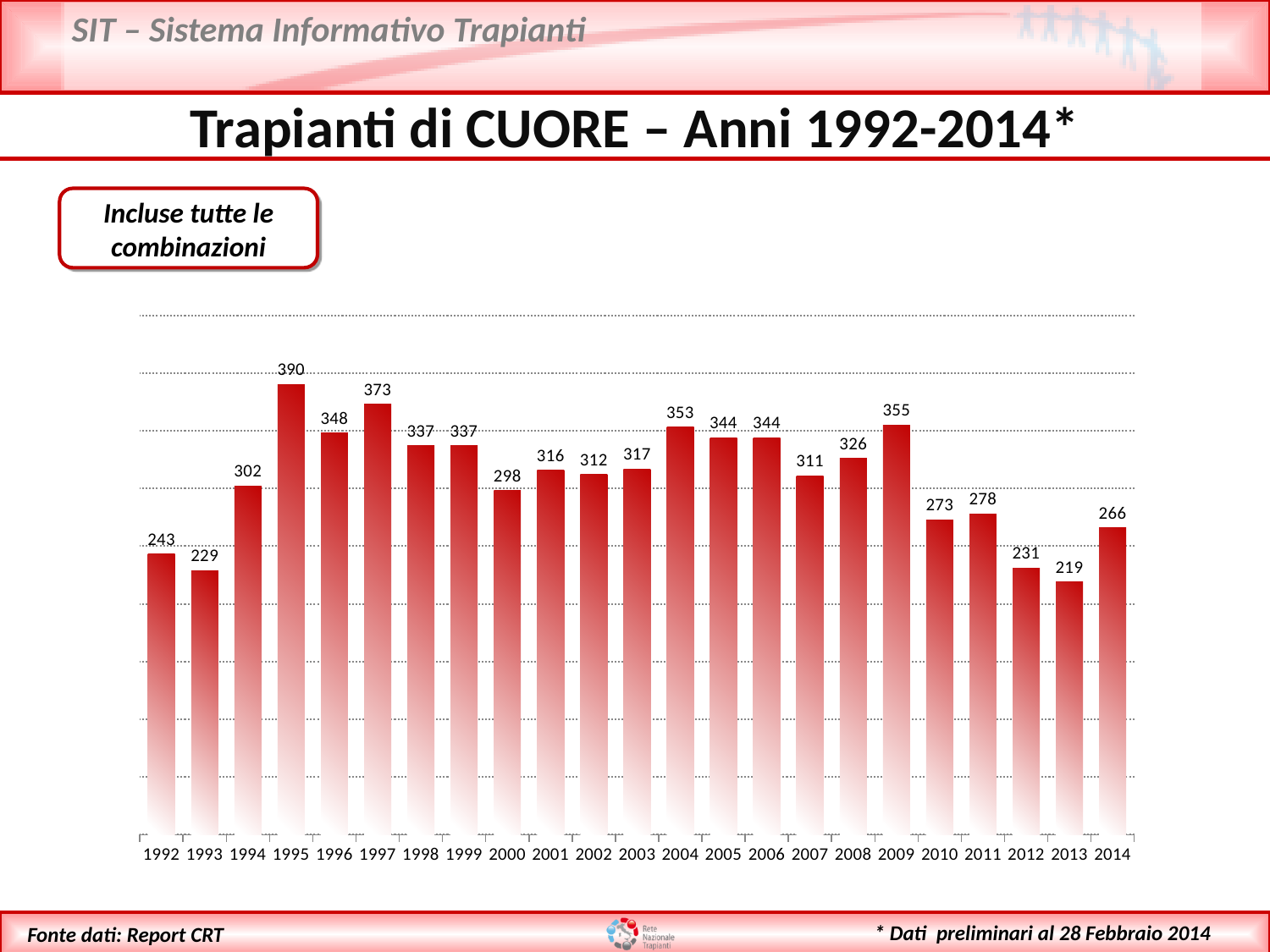
Which is larger, the value for 1992 or the value for 2012? 1992 What kind of chart is shown on the slide? bar chart What is the value for 2013? 219 What is the difference between the values for 1995 and 2013? 171 What is the value for 2009? 355 What is the value for 1995? 390 Which year has the highest value? 1995 What is the title of the slide's chart? Trapianti di CUORE – Anni 1992-2014* Which year has the lowest value? 2013 How many years are shown on the x axis? 23 Which is larger, the value for 1997 or the value for 2009? 1997 What is the difference between the values for 2014 and 2013? 47